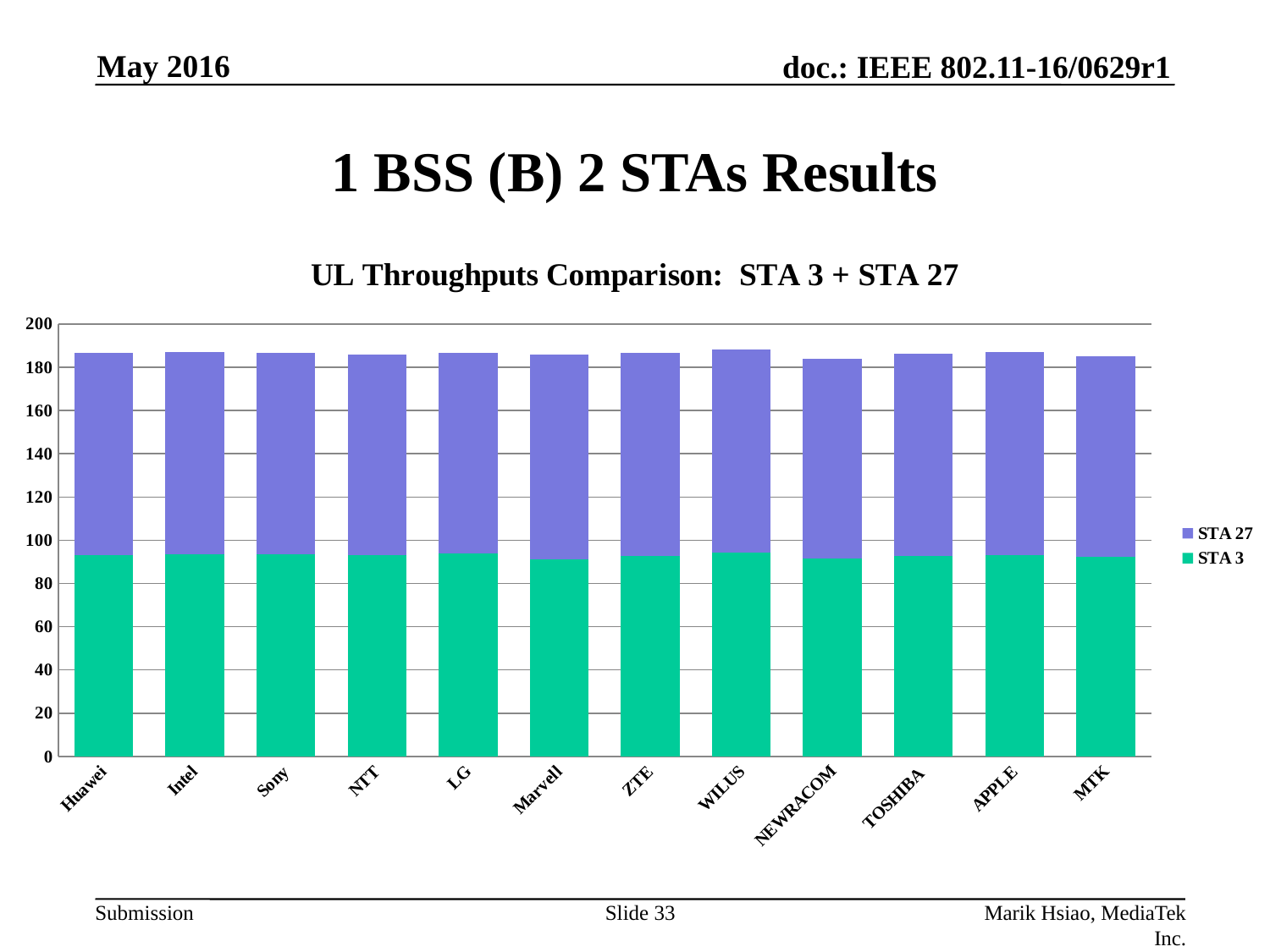
Is the STA 3 value for Huawei greater or less than 80? greater How many series does the chart legend list? 2 Is the total stacked bar for MTK greater or less than 160? greater What kind of chart is shown on the slide? stacked bar chart Is the total stacked bar for Intel greater or less than 180? greater What is the title of the chart? UL Throughputs Comparison: STA 3 + STA 27 What is the highest value shown on the y axis of the chart? 200 How many companies are shown along the x axis of the chart? 12 Which series is shown in green in the chart? STA 3